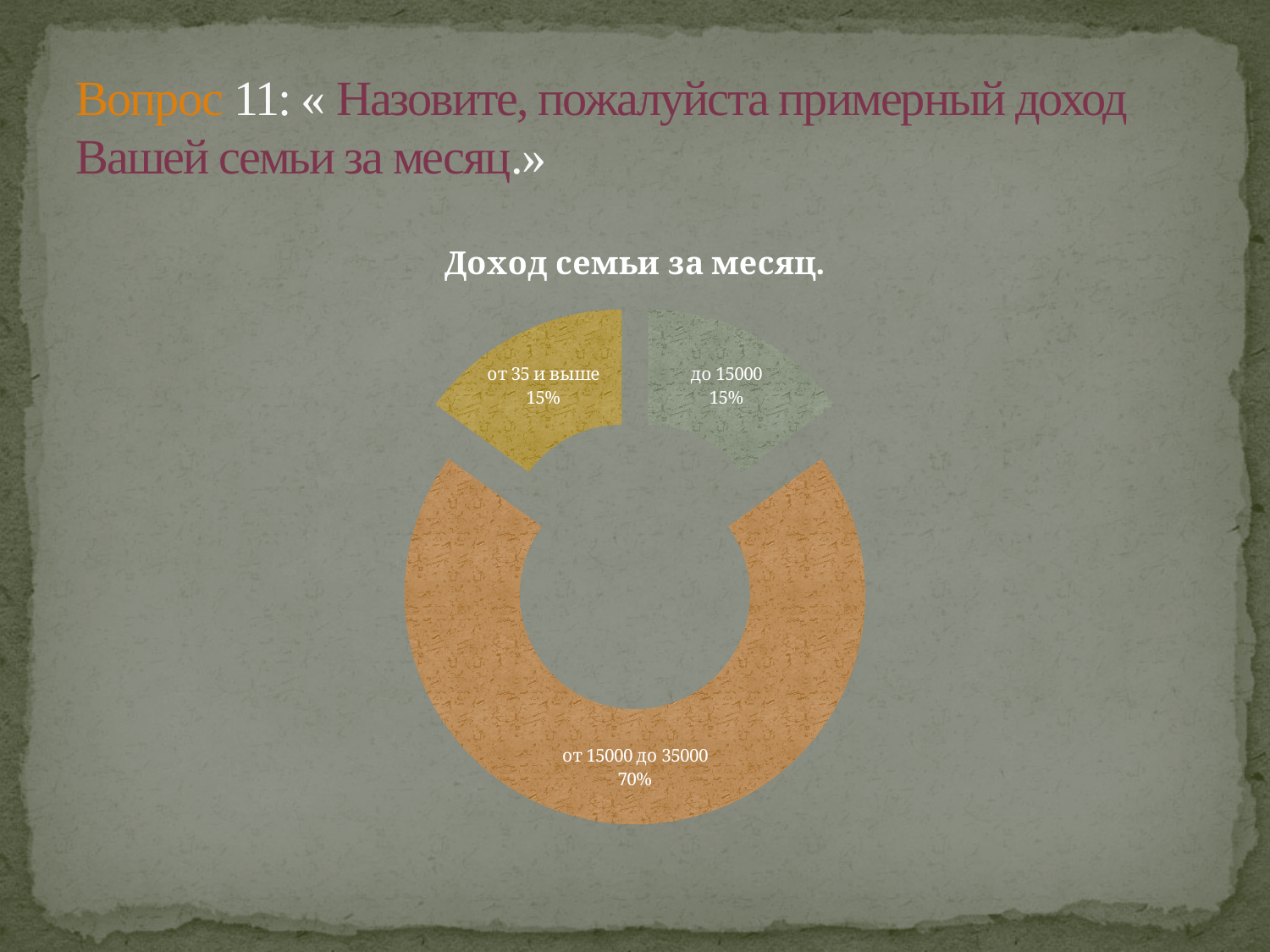
What is the difference in percentage points between the share for "от 15000 до 35000" and the share for "до 15000"? 55 Which is larger: the share for "от 15000 до 35000" or the share for "от 35 и выше"? от 15000 до 35000 What share of the chart does the category "от 15000 до 35000" have? 70% Which category has the largest share of the chart? от 15000 до 35000 Is the share for "от 15000 до 35000" greater or less than 50%? greater What share of the chart does the category "от 35 и выше" have? 15% How many categories are shown in the chart? 3 What share of the chart does the category "до 15000" have? 15% What is the combined share of the categories "до 15000" and "от 35 и выше"? 30% What kind of chart is shown on the slide? Doughnut (pie) chart What is the title of the chart? Доход семьи за месяц.